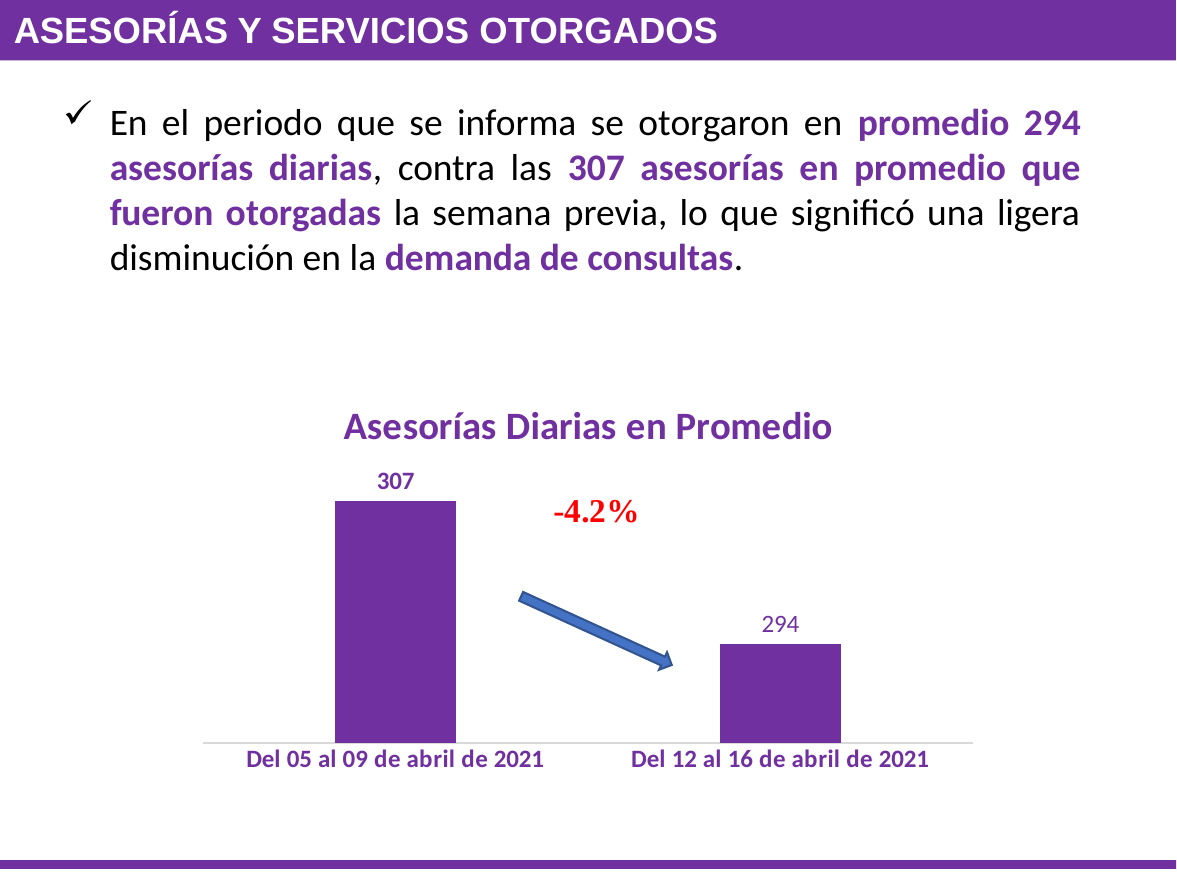
What is the value for 'Del 12 al 16 de abril de 2021' in the chart? 294 How many categories are shown in the chart? 2 What percentage change is annotated between the two bars in the chart? -4.2% What is the value for 'Del 05 al 09 de abril de 2021' in the chart? 307 What kind of chart is shown on the slide? Bar chart Which is larger: the value for 'Del 05 al 09 de abril de 2021' or for 'Del 12 al 16 de abril de 2021'? Del 05 al 09 de abril de 2021 Which period has the lowest value in the chart? Del 12 al 16 de abril de 2021 Do the values rise or fall from the first period to the second? Fall What is the title of the chart? Asesorías Diarias en Promedio What is the difference between the values for 'Del 05 al 09 de abril de 2021' and 'Del 12 al 16 de abril de 2021'? 13 Which period has the highest value in the chart? Del 05 al 09 de abril de 2021